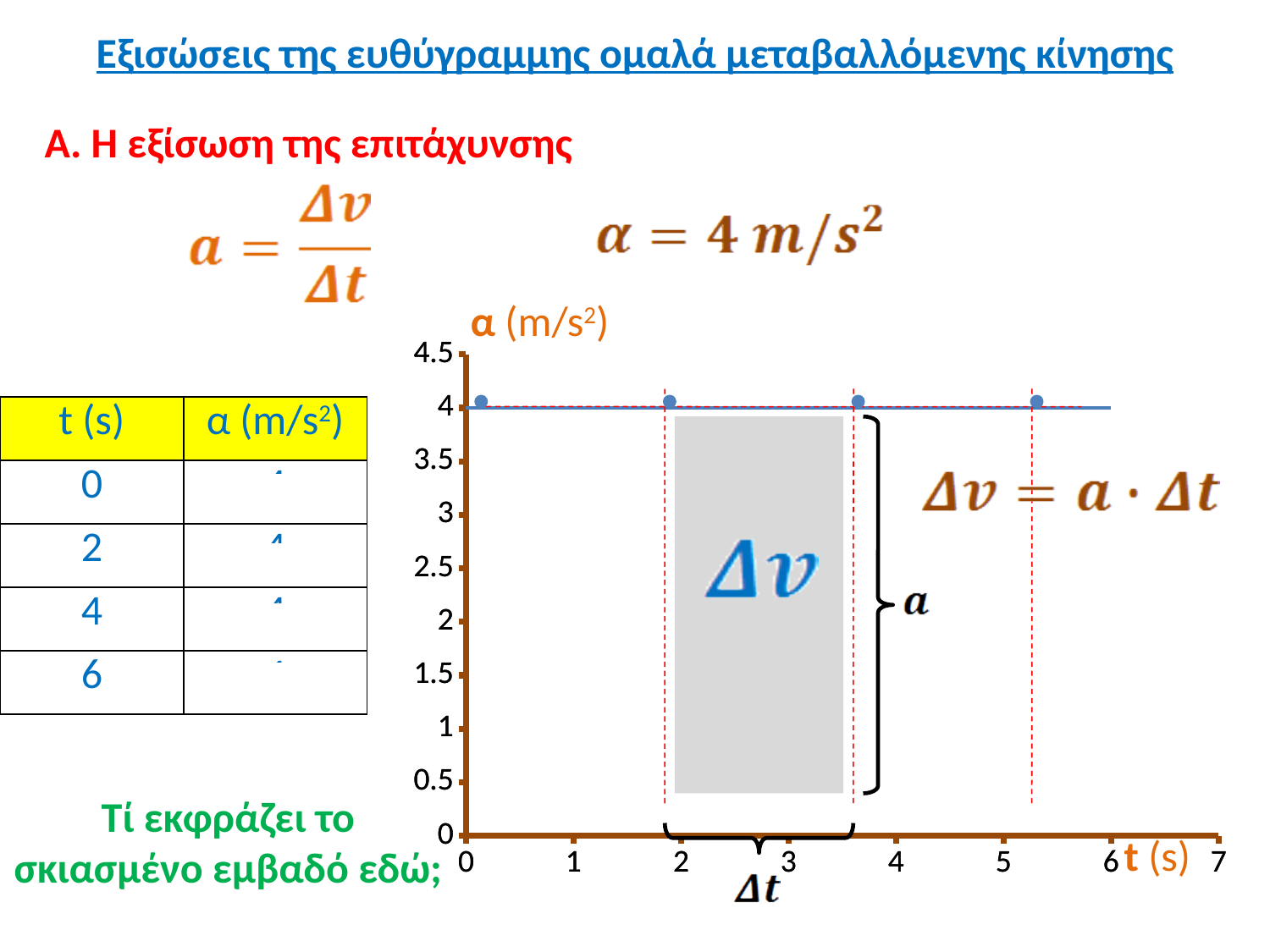
What is the difference between the value of α at t = 0 s and at t = 6 s? 0 What is the value of α at t = 6 s on the chart? 4 Is the value of α at t = 0 s greater or less than 4.5? less What is the label of the vertical axis of the chart? α (m/s²) Do the plotted values of α rise, fall, or stay constant as t increases? stay constant What is the label of the horizontal axis of the chart? t (s) How many data points are plotted on the chart? 4 What is the highest tick value shown on the vertical axis? 4.5 Is the value of α at t = 4 s greater or less than 3.5? greater What is the highest tick value shown on the horizontal axis? 7 What is the value of α at t = 2 s on the chart? 4